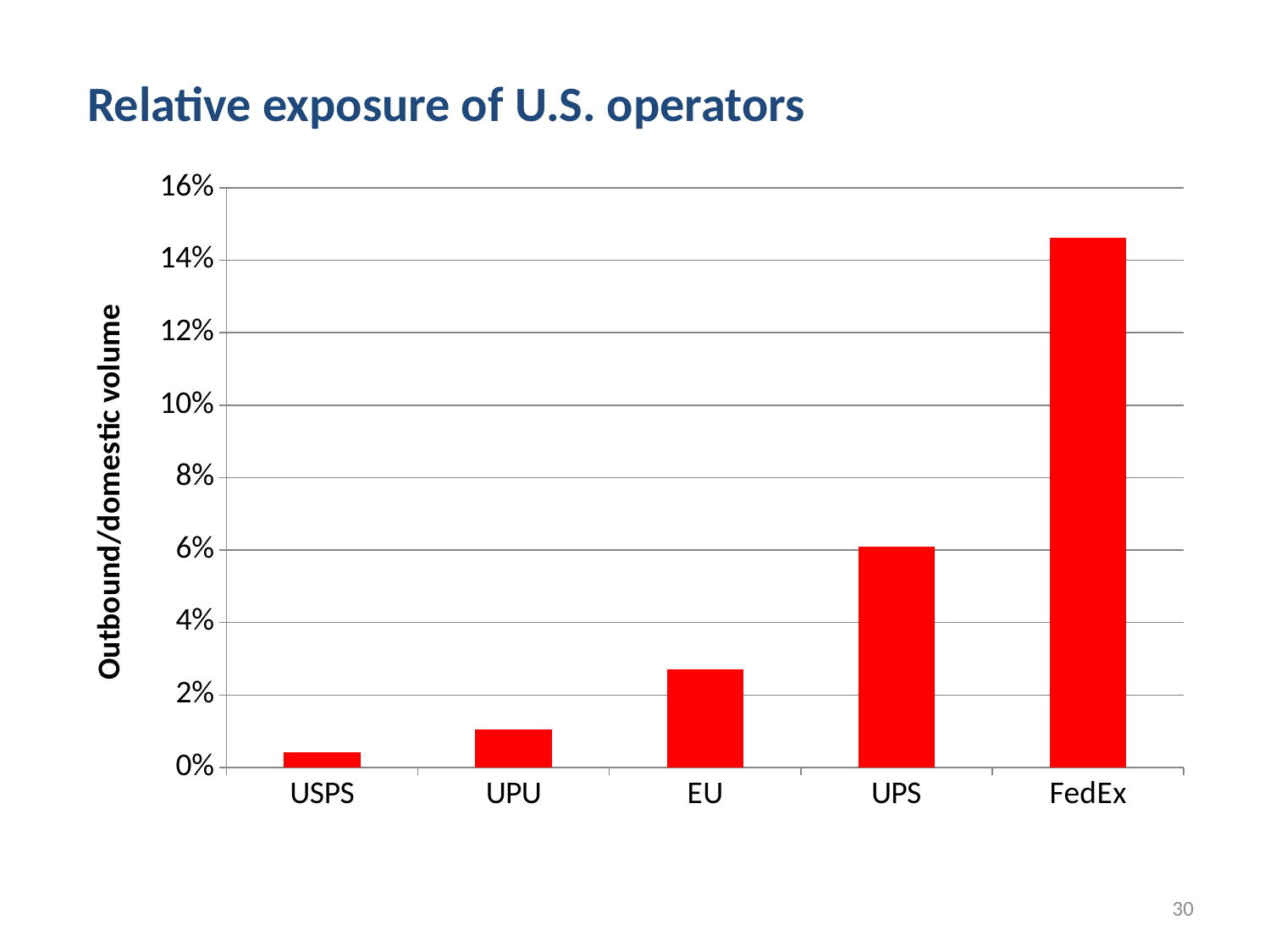
Which category has the lowest outbound/domestic volume? USPS Is the value for USPS greater or less than 2%? less What type of chart is shown on the slide? bar chart Do the values rise or fall moving from USPS to FedEx along the x axis? rise What is the label of the vertical axis of the chart? Outbound/domestic volume Is the value for EU greater or less than 2%? greater Is the value for FedEx greater or less than 14%? greater Which has a larger outbound/domestic volume, UPS or EU? UPS Which has a larger outbound/domestic volume, UPU or USPS? UPU How many categories are shown on the x axis of the chart? 5 Which category has the highest outbound/domestic volume? FedEx